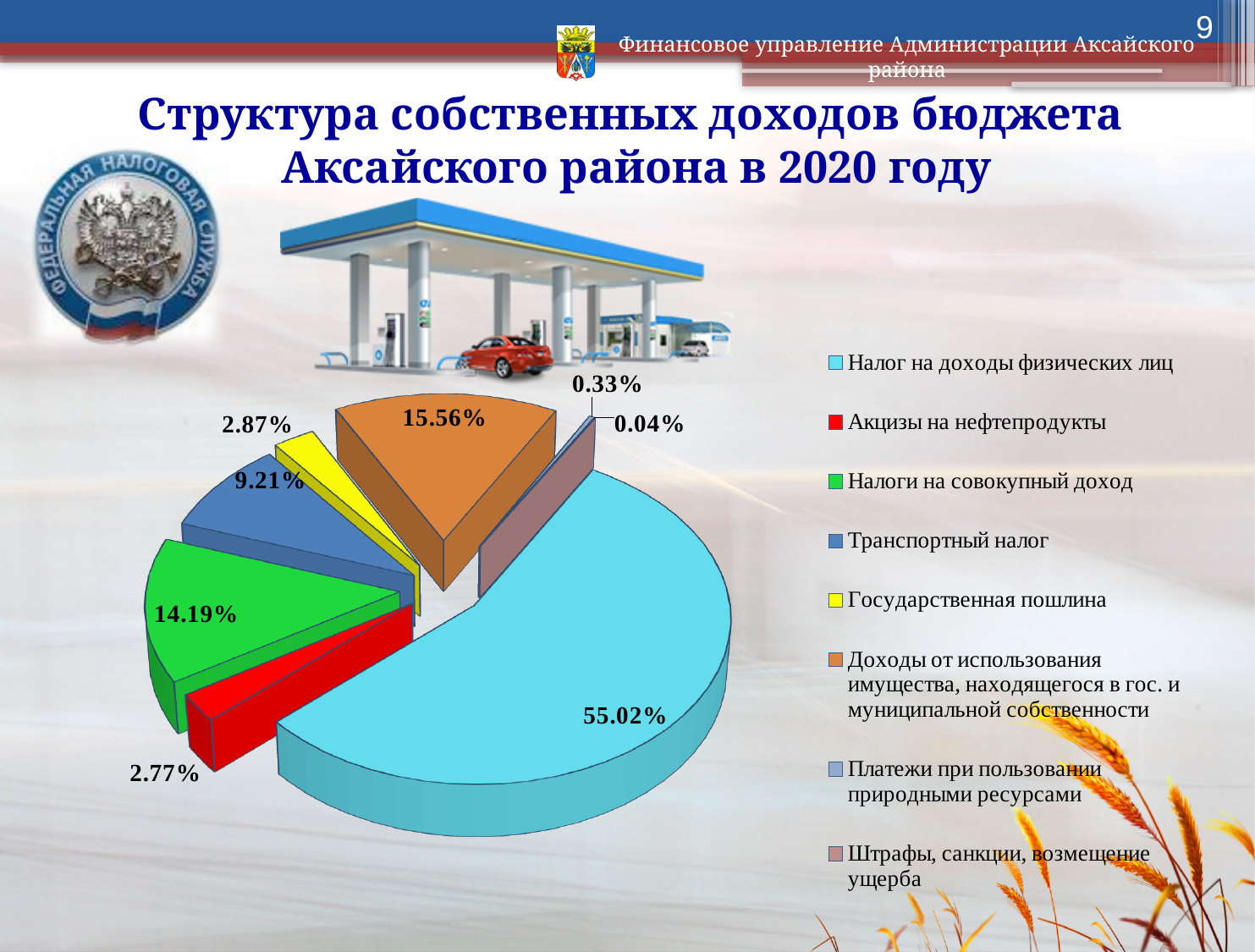
What is the value shown for Налоги на совокупный доход? 14.19% What is the difference between the shares of Доходы от использования имущества and Налоги на совокупный доход? 1.37% What is the smallest percentage shown on the pie chart? 0.04% What is the value shown for Государственная пошлина? 2.87% Which category has the largest share of the pie? Налог на доходы физических лиц What kind of chart is shown on the slide? pie chart How many categories does the legend list? 8 What is the value shown for Доходы от использования имущества, находящегося в гос. и муниципальной собственности? 15.56% What is the value shown for Акцизы на нефтепродукты? 2.77% What share of the pie does Налог на доходы физических лиц have? 55.02% What is the value shown for Транспортный налог? 9.21% Which is larger: Налоги на совокупный доход or Транспортный налог? Налоги на совокупный доход